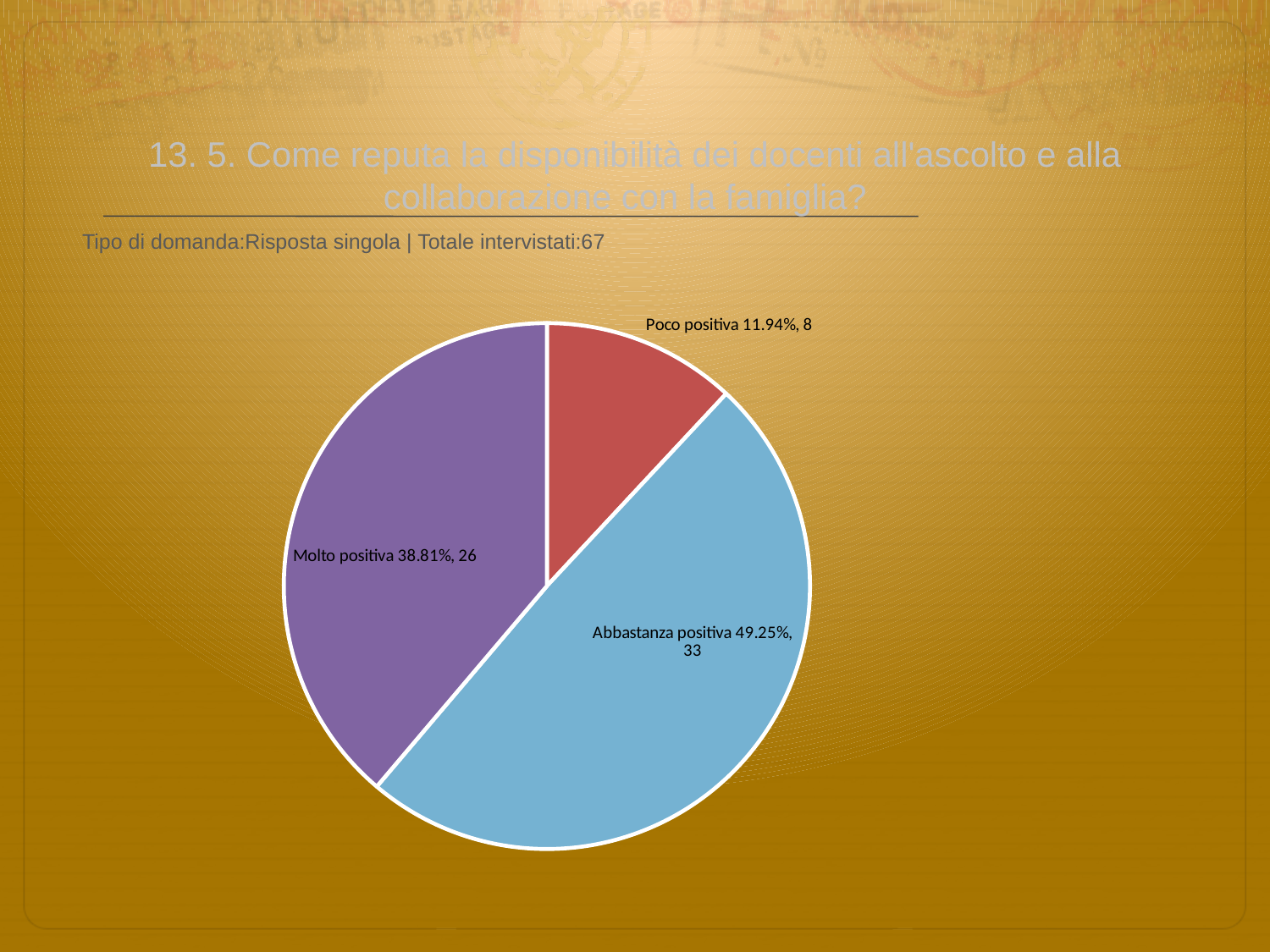
How many respondents chose 'Abbastanza positiva'? 33 What percentage share does the 'Poco positiva' slice have? 11.94% What percentage share does the 'Abbastanza positiva' slice have? 49.25% How many respondents chose 'Poco positiva'? 8 Which category has the smallest slice of the pie? Poco positiva How many slices does the pie chart have? 3 What kind of chart is shown on the slide? pie chart What is the difference in respondent count between 'Abbastanza positiva' and 'Molto positiva'? 7 What percentage share does the 'Molto positiva' slice have? 38.81% Which has more respondents, 'Molto positiva' or 'Poco positiva'? Molto positiva How many respondents chose 'Molto positiva'? 26 Which category has the largest slice of the pie? Abbastanza positiva